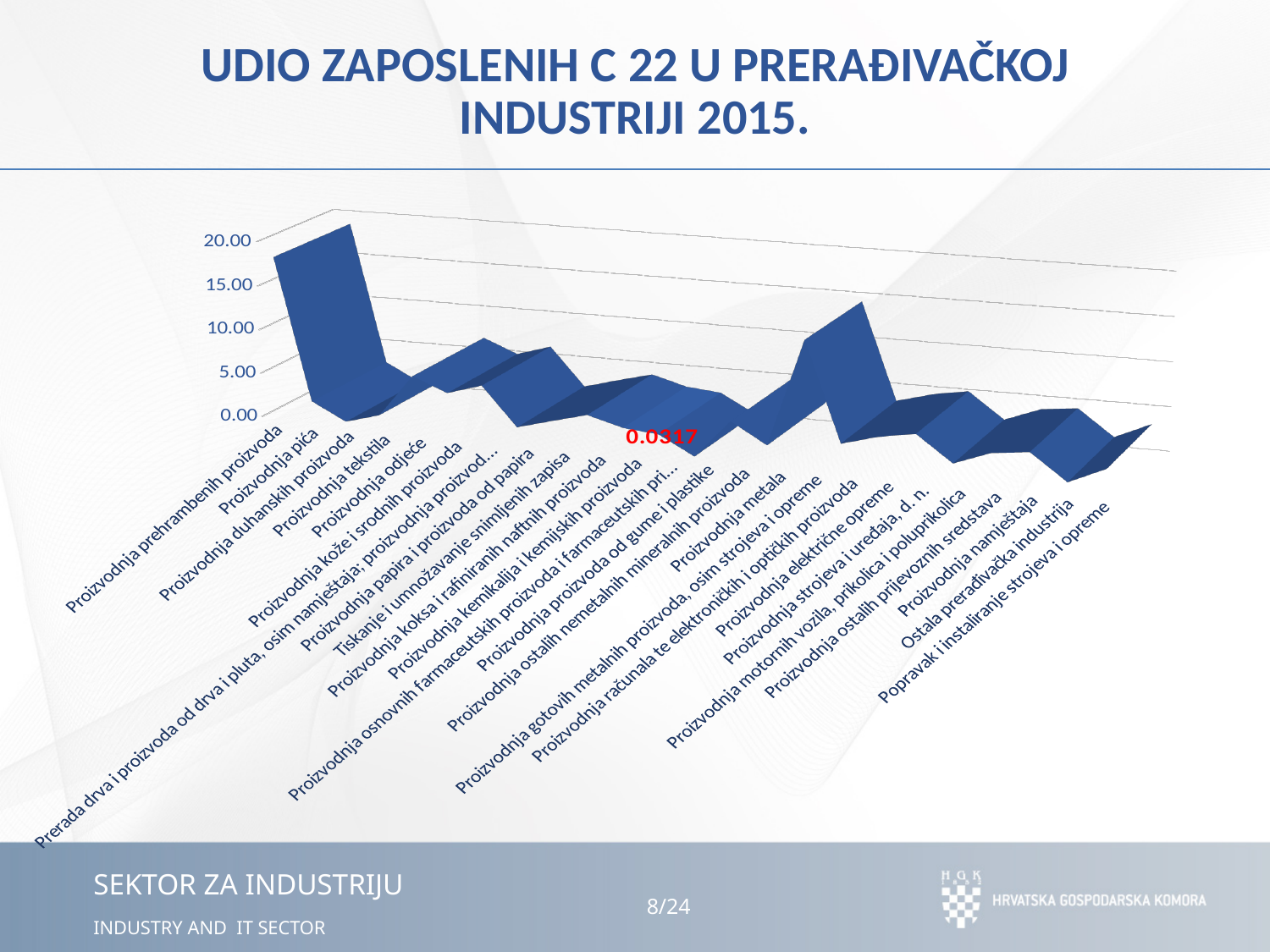
What is the title of the chart on the slide? UDIO ZAPOSLENIH C 22 U PRERAĐIVAČKOJ INDUSTRIJI 2015. Is the value for Proizvodnja prehrambenih proizvoda greater or less than 10.00? greater What is the highest tick value shown on the vertical axis of the chart? 20.00 Is the value for Proizvodnja tekstila greater or less than 10.00? less How many categories are plotted along the x axis of the chart? 24 Which is larger, the value for Proizvodnja gotovih metalnih proizvoda, osim strojeva i opreme or the value for Proizvodnja koksa i rafiniranih naftnih proizvoda? Proizvodnja gotovih metalnih proizvoda, osim strojeva i opreme Which category is plotted last (rightmost) on the x axis? Popravak i instaliranje strojeva i opreme Which category has the highest value in the chart? Proizvodnja prehrambenih proizvoda What value is printed as a data label on the chart? 0.0317 Which is larger, the value for Proizvodnja prehrambenih proizvoda or the value for Proizvodnja metala? Proizvodnja prehrambenih proizvoda What kind of chart is shown on the slide? 3D line chart